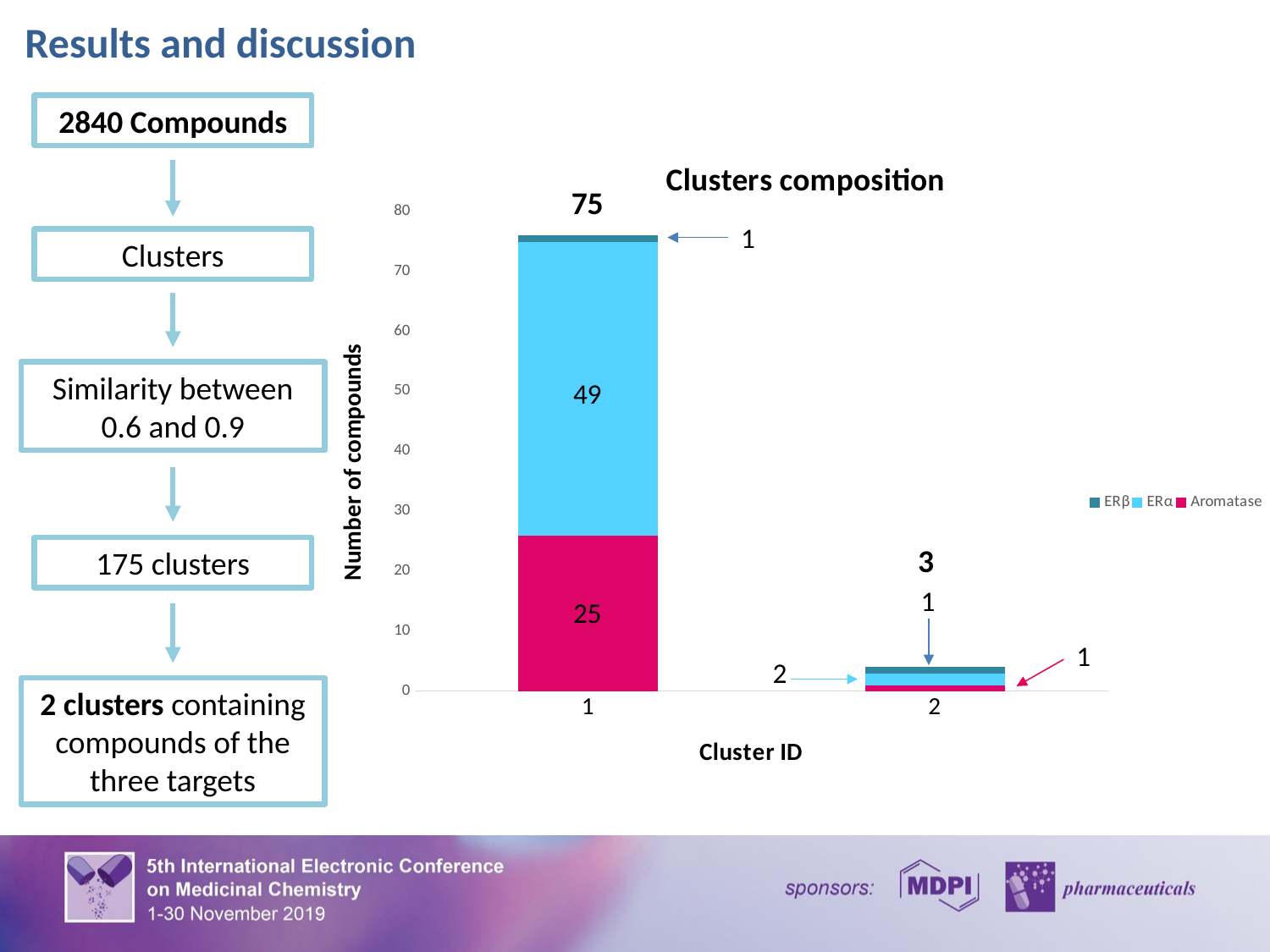
What is the total number of compounds in cluster 1? 75 How many clusters are plotted on the x axis of the chart? 2 What is the number of ERα compounds in cluster 1? 49 What is the title of the chart? Clusters composition How many series does the chart legend list? 3 Which cluster has the larger total number of compounds? 1 What is the number of Aromatase compounds in cluster 1? 25 What is the number of ERα compounds in cluster 2? 2 What is the label of the y axis? Number of compounds What is the total number of compounds in cluster 2? 3 What is the difference between the ERα and Aromatase counts in cluster 1? 24 What kind of chart is shown on the slide? stacked bar chart